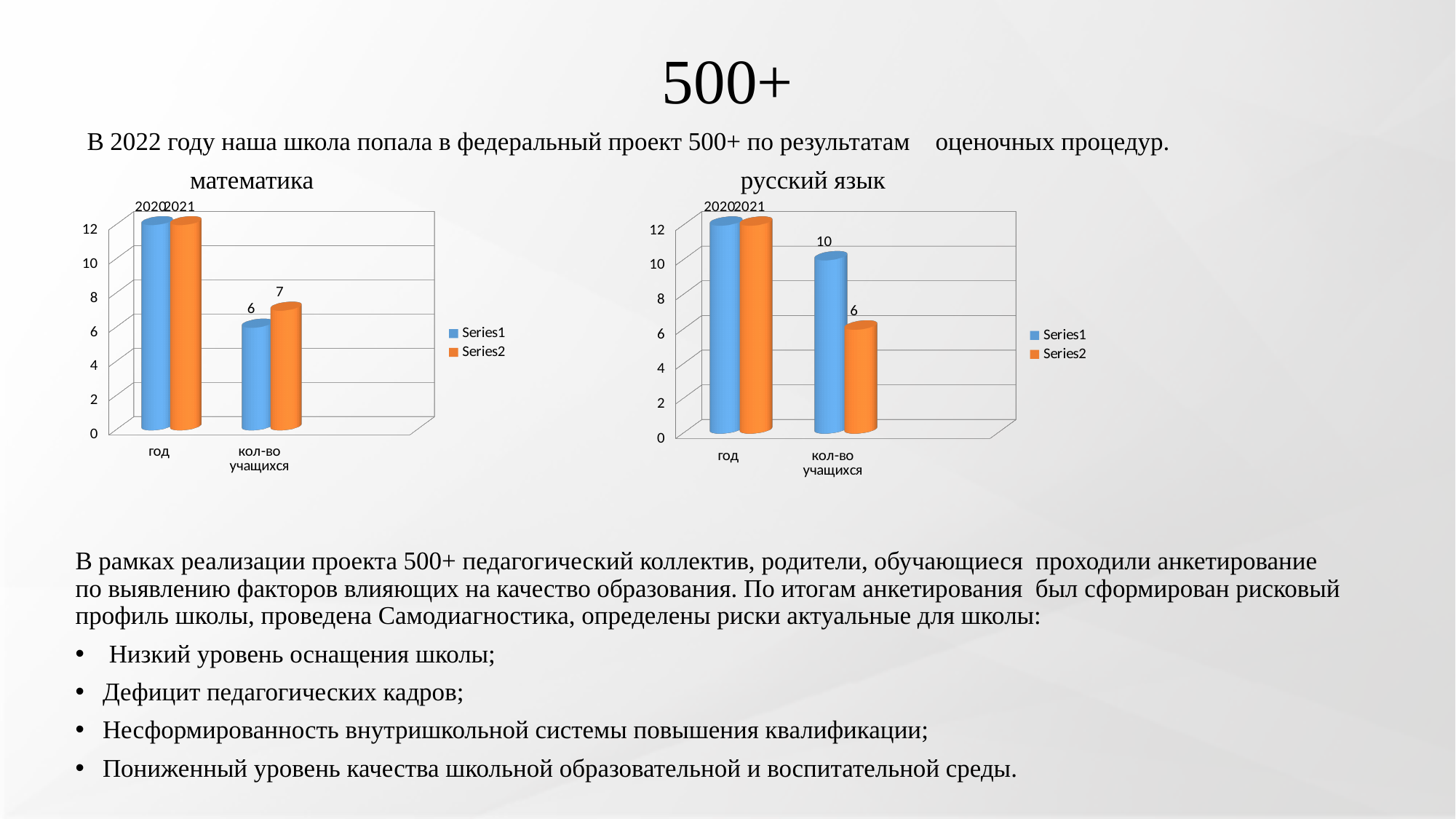
In the русский язык chart, what is the difference between Series1 and Series2 for кол-во учащихся? 4 In the математика chart, what is the value of Series2 for кол-во учащихся? 7 How many categories are shown on the x axis of the математика chart? 2 In the русский язык chart, which series has the larger value for кол-во учащихся, Series1 or Series2? Series1 In the русский язык chart, what is the value of Series2 for кол-во учащихся? 6 In the математика chart, what is the difference between Series2 and Series1 for кол-во учащихся? 1 In the математика chart, what is the value of Series1 for кол-во учащихся? 6 In the математика chart, what data label is shown on the Series1 bar for год? 2020 In the математика chart, which series has the larger value for кол-во учащихся, Series1 or Series2? Series2 In the русский язык chart, what is the value of Series1 for кол-во учащихся? 10 How many series does the legend of the русский язык chart list? 2 What kind of chart is the математика chart? bar chart